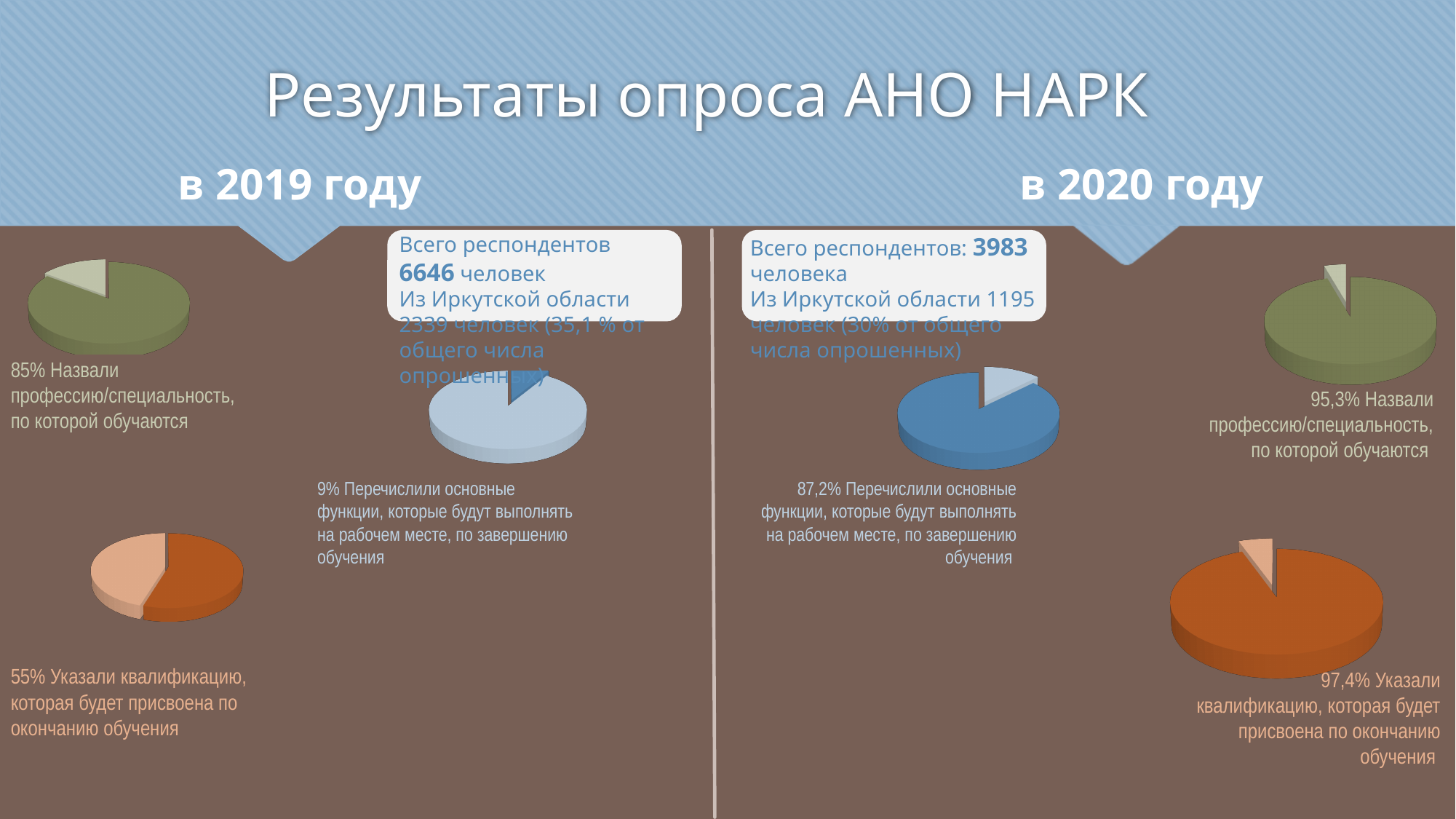
What is the title of the slide? Результаты опроса АНО НАРК On the 2019 orange pie chart, what share of respondents indicated the qualification to be awarded on completion of training? 55% On the 2019 blue pie chart, what share of respondents listed the main functions they will perform at the workplace? 9% On the 2019 green pie chart, what share of respondents named the profession/specialty they are studying? 85% What is the difference between the 2020 and 2019 shares of respondents who named their profession/specialty (green pie charts)? 10,3% On the 2020 green pie chart, what share of respondents named the profession/specialty they are studying? 95,3% Comparing the blue pie charts, which year has the larger share of respondents who listed the main workplace functions, 2019 or 2020? 2020 What type of chart is used throughout this slide? Pie chart On the 2020 blue pie chart, what share of respondents listed the main functions they will perform at the workplace? 87,2% On the 2020 orange pie chart, what share of respondents indicated the qualification to be awarded on completion of training? 97,4% How many pie charts are shown on the slide? 6 What is the difference between the 2020 and 2019 shares of respondents who indicated the qualification to be awarded (orange pie charts)? 42,4%